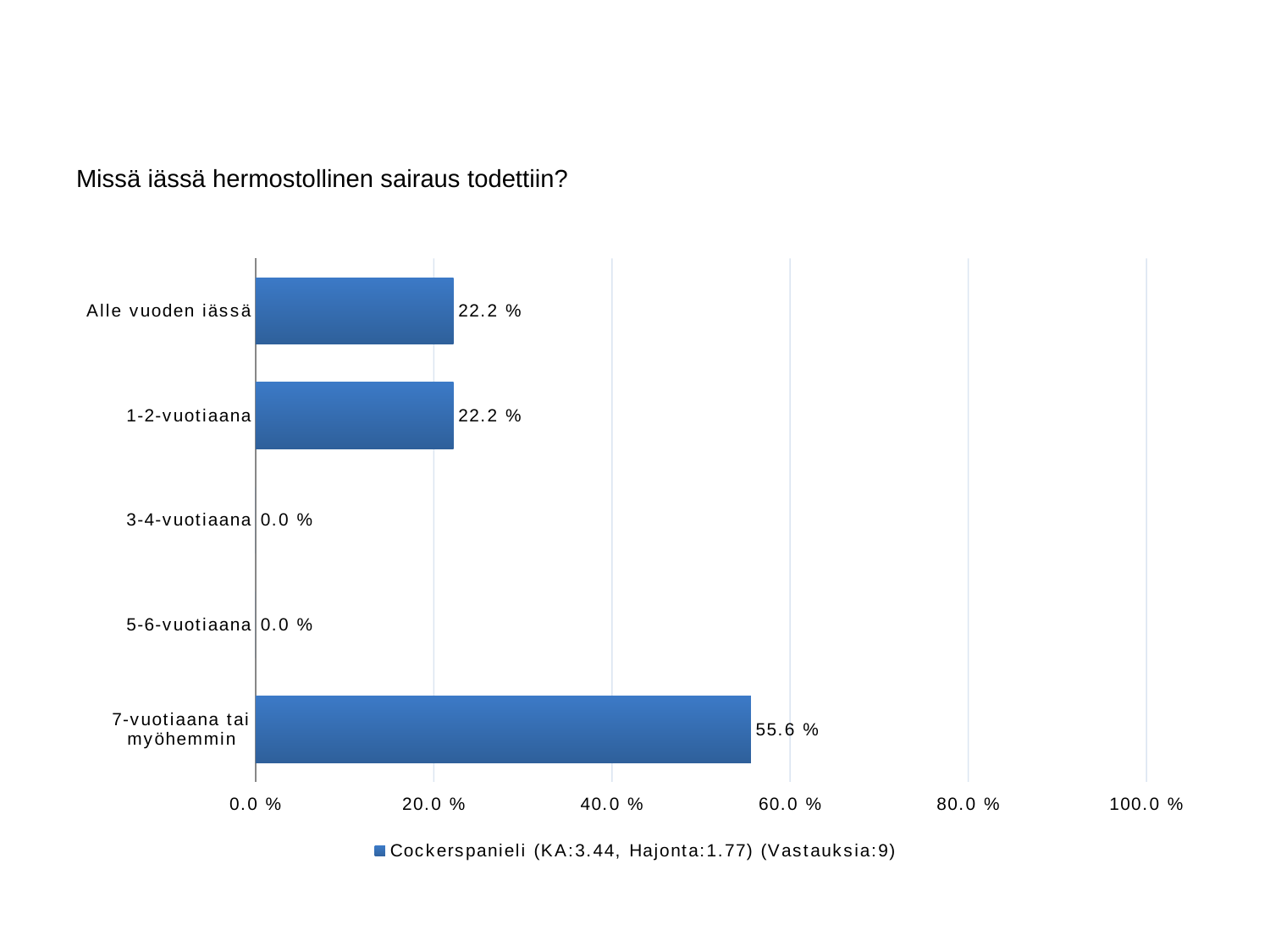
How many categories have a value of 0.0 %? 2 How many series does the legend list? 1 What kind of chart is shown on the slide? Bar chart What is the value for "7-vuotiaana tai myöhemmin"? 55.6 % What is the value for "3-4-vuotiaana"? 0.0 % Which is larger, the value for "7-vuotiaana tai myöhemmin" or the value for "Alle vuoden iässä"? 7-vuotiaana tai myöhemmin Is the value for "7-vuotiaana tai myöhemmin" greater or less than 40.0 %? greater What is the value for "Alle vuoden iässä"? 22.2 % How many categories are shown on the chart? 5 What is the difference between the values for "7-vuotiaana tai myöhemmin" and "1-2-vuotiaana"? 33.4 % What is the title of the chart? Missä iässä hermostollinen sairaus todettiin? Which category has the highest value? 7-vuotiaana tai myöhemmin